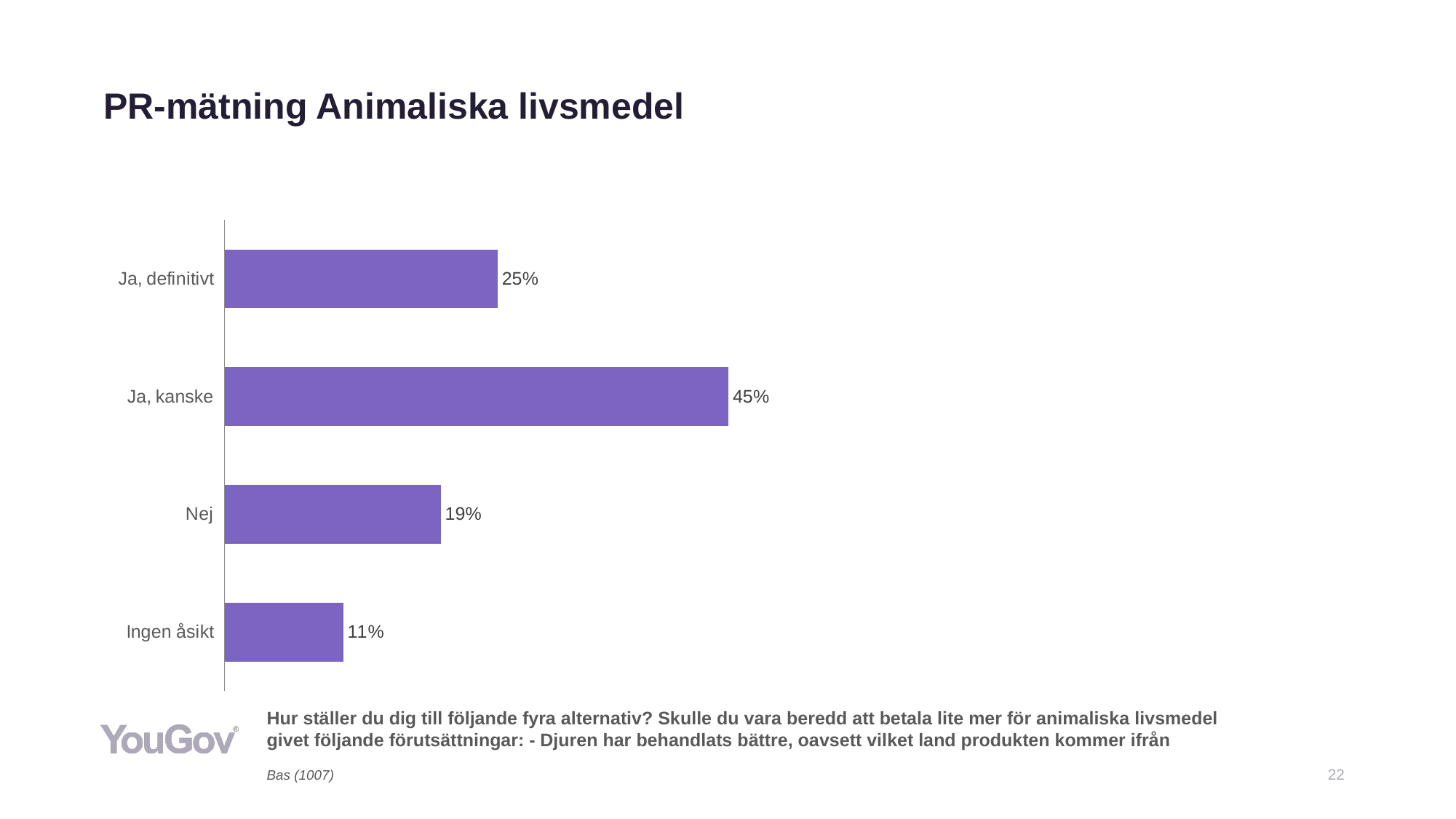
What is the title of the slide? PR-mätning Animaliska livsmedel What is the difference between the values for "Nej" and "Ingen åsikt"? 8% Which category has the lowest value? Ingen åsikt What is the value for "Ja, kanske"? 45% Which is larger, the value for "Ja, definitivt" or the value for "Nej"? Ja, definitivt What kind of chart is shown on the slide? Bar chart What is the value for "Nej"? 19% What is the difference between the values for "Ja, kanske" and "Ja, definitivt"? 20% What is the value for "Ja, definitivt"? 25% Which category has the highest value? Ja, kanske How many categories are shown in the chart? 4 What is the value for "Ingen åsikt"? 11%